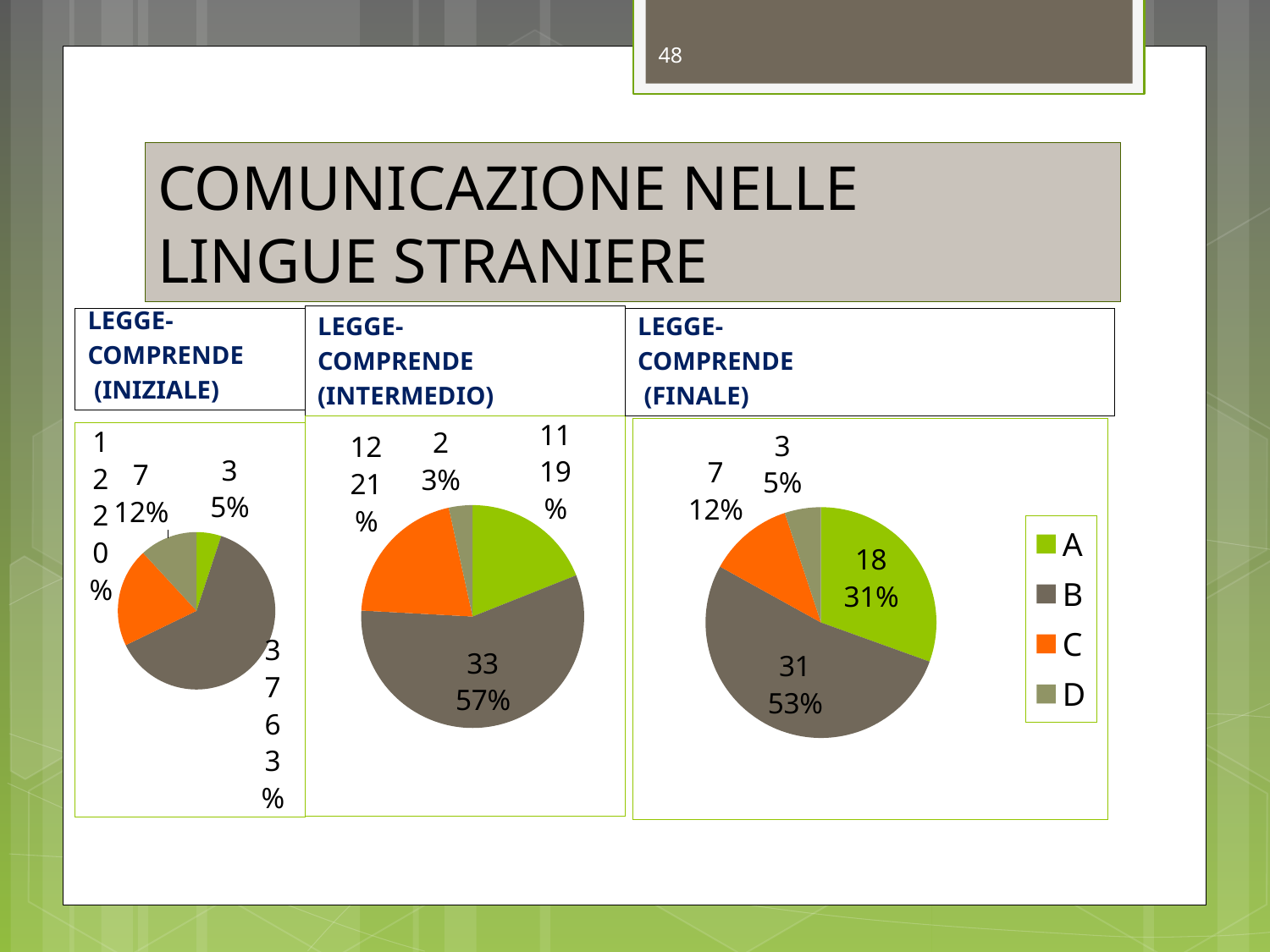
In the LEGGE-COMPRENDE (INTERMEDIO) chart, what is the value for the green slice (A)? 11 How many series does the legend on the slide list? 4 In the LEGGE-COMPRENDE (INTERMEDIO) chart, which is larger, the orange slice (C) or the green slice (A)? C In the LEGGE-COMPRENDE (FINALE) chart, what is the value for A? 18 What kind of charts are shown on the slide? Pie charts In the LEGGE-COMPRENDE (FINALE) chart, what is the difference between the values for B and A? 13 What is the title of the slide above the charts? COMUNICAZIONE NELLE LINGUE STRANIERE In the LEGGE-COMPRENDE (FINALE) chart, which category has the smallest slice? D In the LEGGE-COMPRENDE (FINALE) chart, what share of the pie does slice B have? 53% In the LEGGE-COMPRENDE (INTERMEDIO) chart, what share of the pie does the largest slice have? 57% How many pie charts are on the slide? 3 In the LEGGE-COMPRENDE (INIZIALE) chart, what share of the pie does the largest slice have? 63%